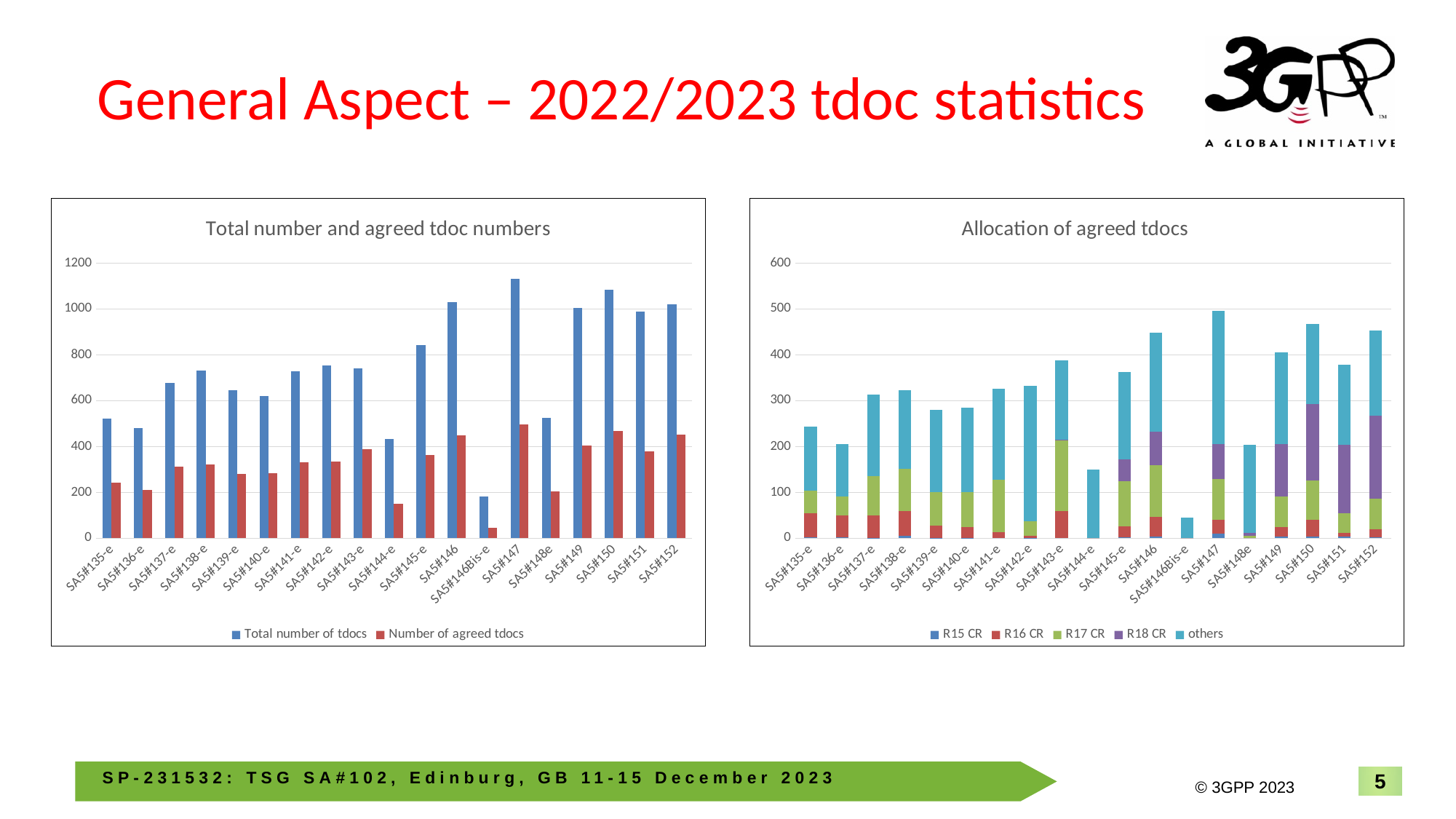
On the right chart 'Allocation of agreed tdocs', which meeting has the tallest stacked bar? SA5#147 On the left chart, which meeting has the highest total number of tdocs? SA5#147 On the right chart, is the stacked total for SA5#152 greater or less than 400? greater On the left chart, which meeting has the lowest total number of tdocs? SA5#146Bis-e On the left chart, is the total number of tdocs for SA5#150 greater or less than 1000? greater How many series does the legend of the right chart list? 5 What kind of chart is the right chart 'Allocation of agreed tdocs'? Stacked bar chart How many series does the legend of the left chart list? 2 On the left chart, which is larger: the total number of tdocs for SA5#150 or for SA5#149? SA5#150 How many meetings are shown on the x axis of the left chart? 19 On the right chart 'Allocation of agreed tdocs', which meeting has the shortest stacked bar? SA5#146Bis-e On the left chart, is the number of agreed tdocs for SA5#144-e greater or less than 200? less